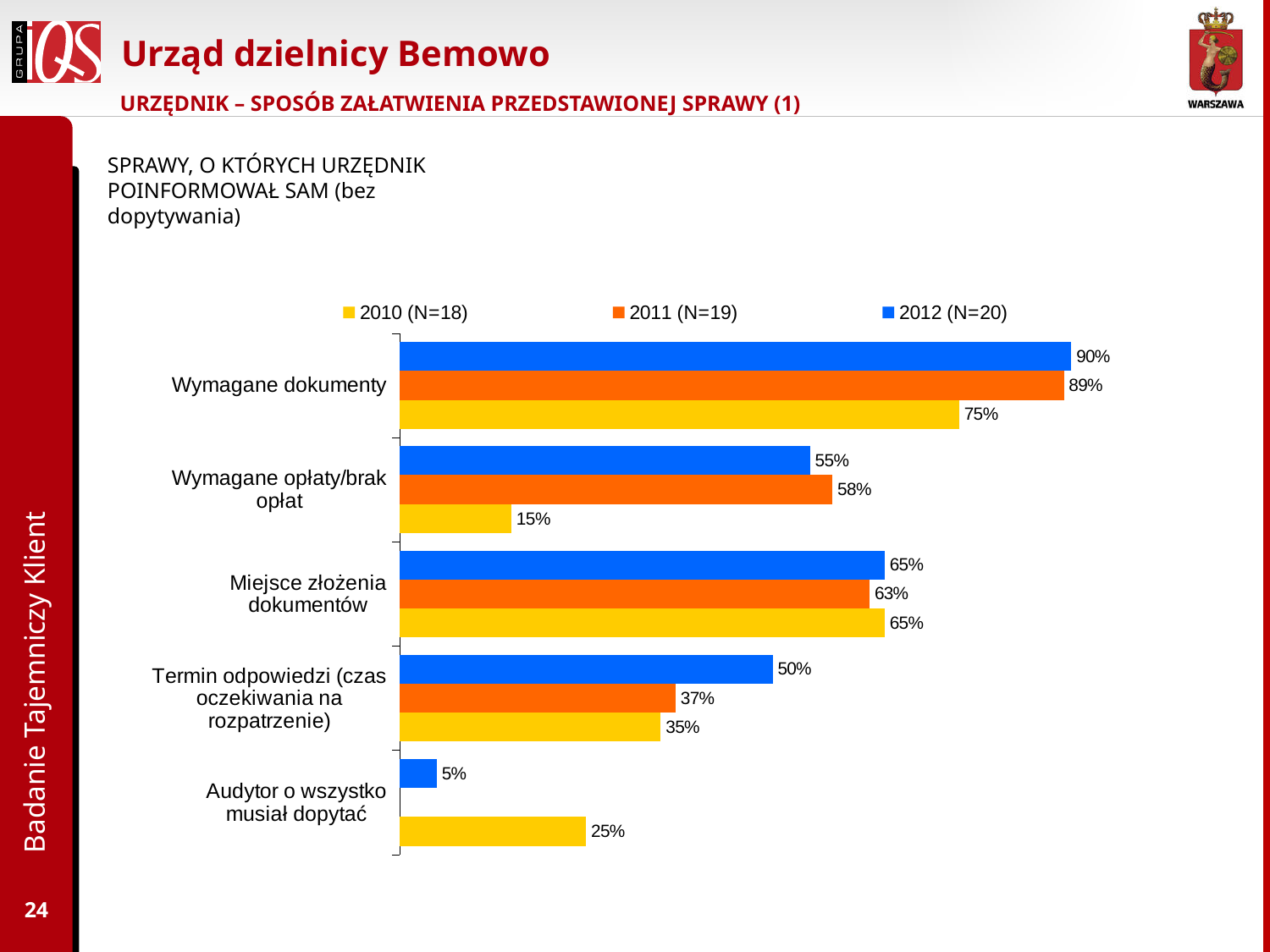
What kind of chart is shown on the slide? Bar chart What is the value for 'Termin odpowiedzi (czas oczekiwania na rozpatrzenie)' in the 2011 (N=19) series? 37% For 'Termin odpowiedzi (czas oczekiwania na rozpatrzenie)', which series has the larger value: 2012 (N=20) or 2010 (N=18)? 2012 (N=20) How many categories are shown on the chart? 5 Which category has the highest value in the 2012 (N=20) series? Wymagane dokumenty How many series does the legend list? 3 What is the value for 'Audytor o wszystko musiał dopytać' in the 2010 (N=18) series? 25% Which colour represents the 2011 (N=19) series in the legend? Orange What is the value for 'Wymagane opłaty/brak opłat' in the 2010 (N=18) series? 15% What is the difference between the 2012 (N=20) and 2010 (N=18) values for 'Wymagane opłaty/brak opłat'? 40 percentage points Which category has the lowest value in the 2012 (N=20) series? Audytor o wszystko musiał dopytać What is the value for 'Wymagane dokumenty' in the 2012 (N=20) series? 90%